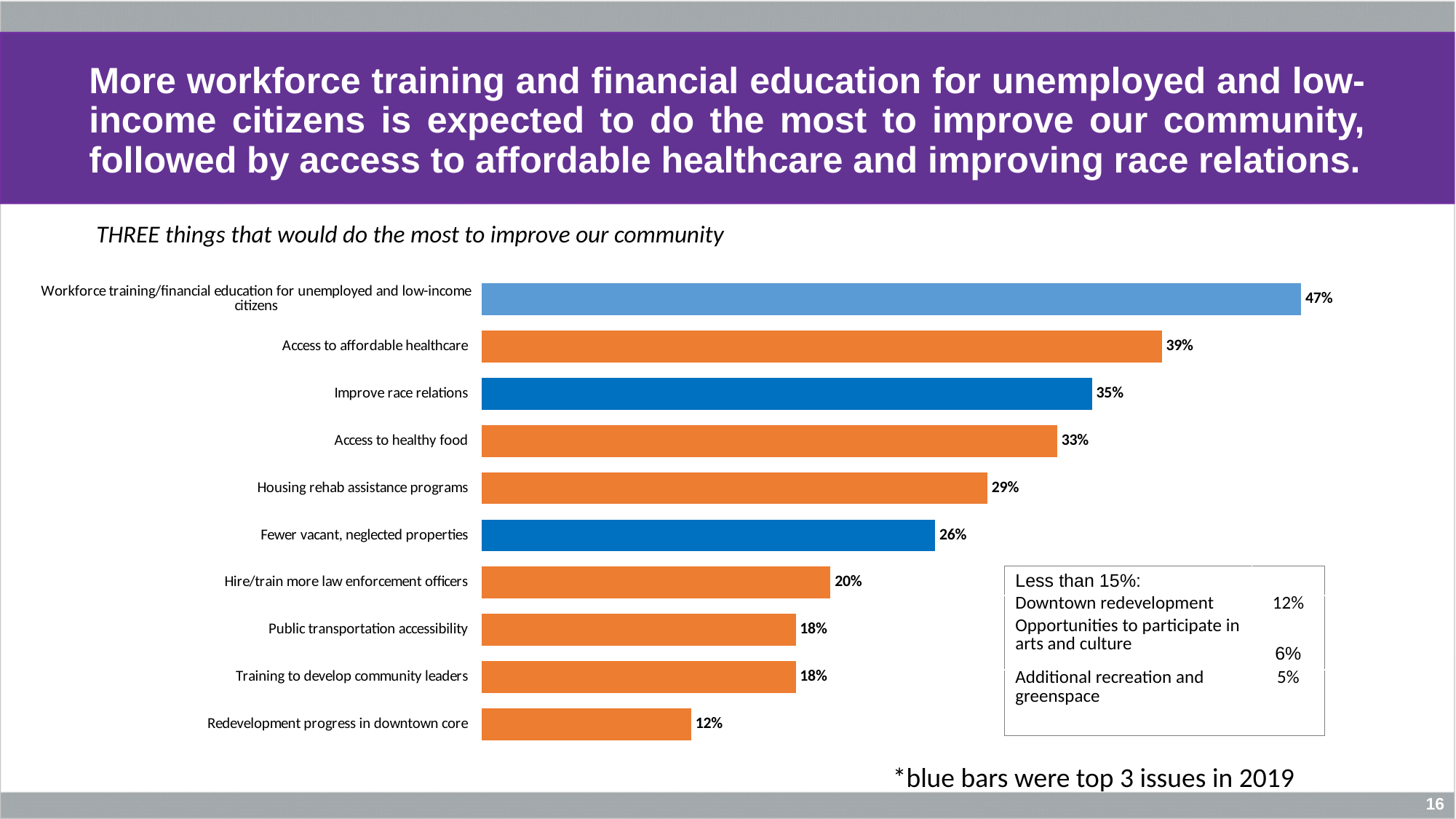
According to the note on the slide, what do the blue bars represent? Top 3 issues in 2019 Which category has the lowest value among the plotted bars? Redevelopment progress in downtown core What is the difference between the values for Access to affordable healthcare and Access to healthy food? 6% What is the difference between the values for Workforce training/financial education for unemployed and low-income citizens and Fewer vacant, neglected properties? 21% What percentage is shown for Hire/train more law enforcement officers? 20% What percentage is shown for Improve race relations? 35% Which category has the highest value in the chart? Workforce training/financial education for unemployed and low-income citizens Which is larger, the value for Access to healthy food or the value for Fewer vacant, neglected properties? Access to healthy food What percentage is shown for Access to affordable healthcare? 39% How many bars are plotted in the chart? 10 What type of chart is shown on the slide? Bar chart What percentage is shown for Housing rehab assistance programs? 29%